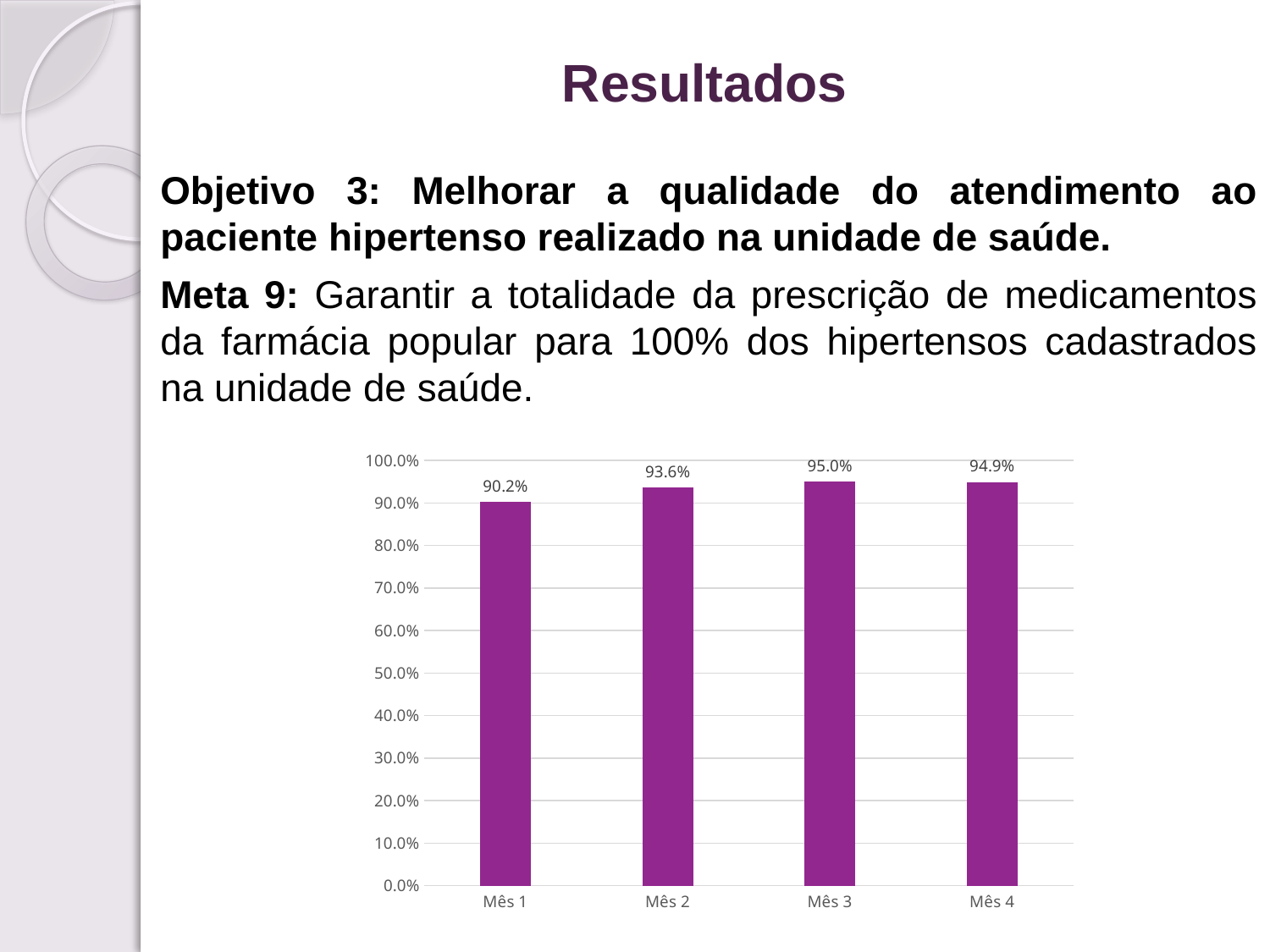
What is the difference between the values for Mês 2 and Mês 1? 3.4% What is the value for Mês 2? 93.6% What is the value for Mês 3? 95.0% Which month has the highest value? Mês 3 What is the value for Mês 4? 94.9% What is the value for Mês 1? 90.2% How many months are shown on the x axis of the chart? 4 Do the values rise or fall from Mês 1 to Mês 3? Rise Which is larger, the value for Mês 2 or the value for Mês 1? Mês 2 What kind of chart is shown on the slide? Bar chart What is the difference between the values for Mês 3 and Mês 1? 4.8% Which month has the lowest value? Mês 1